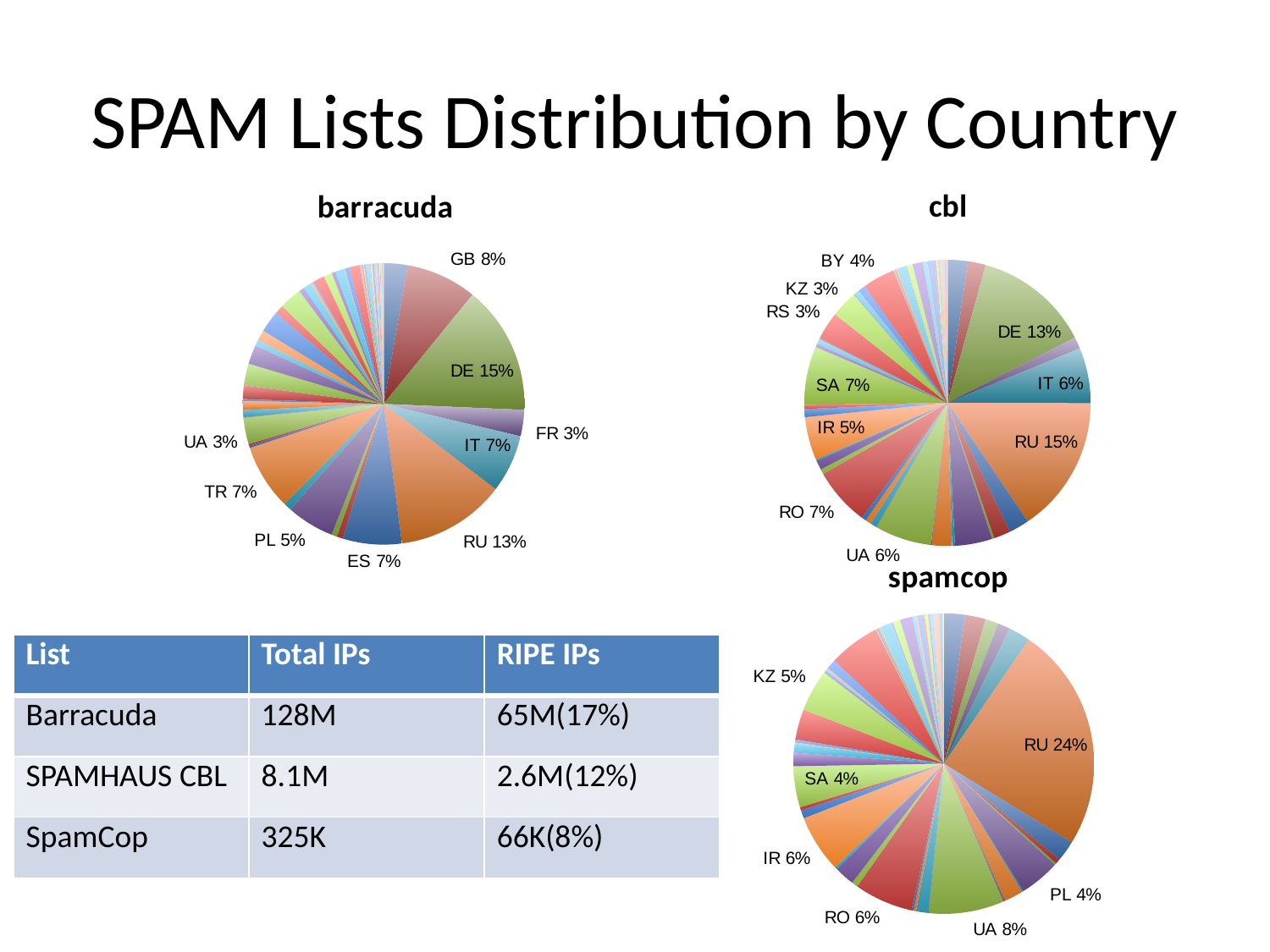
In the spamcop pie chart, what share is labelled for RU? 24% In the cbl pie chart, which is larger, the DE slice or the IT slice? DE In the barracuda pie chart, what share is labelled for RU? 13% What type of chart is the cbl chart? Pie chart In the cbl pie chart, what share is labelled for RU? 15% In the cbl pie chart, what share is labelled for SA? 7% In the barracuda pie chart, what share is labelled for DE? 15% In the spamcop pie chart, what share is labelled for UA? 8% In the spamcop pie chart, what is the difference in percentage points between RU and UA? 16 In the barracuda pie chart, which labelled country has the largest slice? DE In the barracuda pie chart, what is the difference in percentage points between DE and GB? 7 In the spamcop pie chart, which labelled country has the largest slice? RU